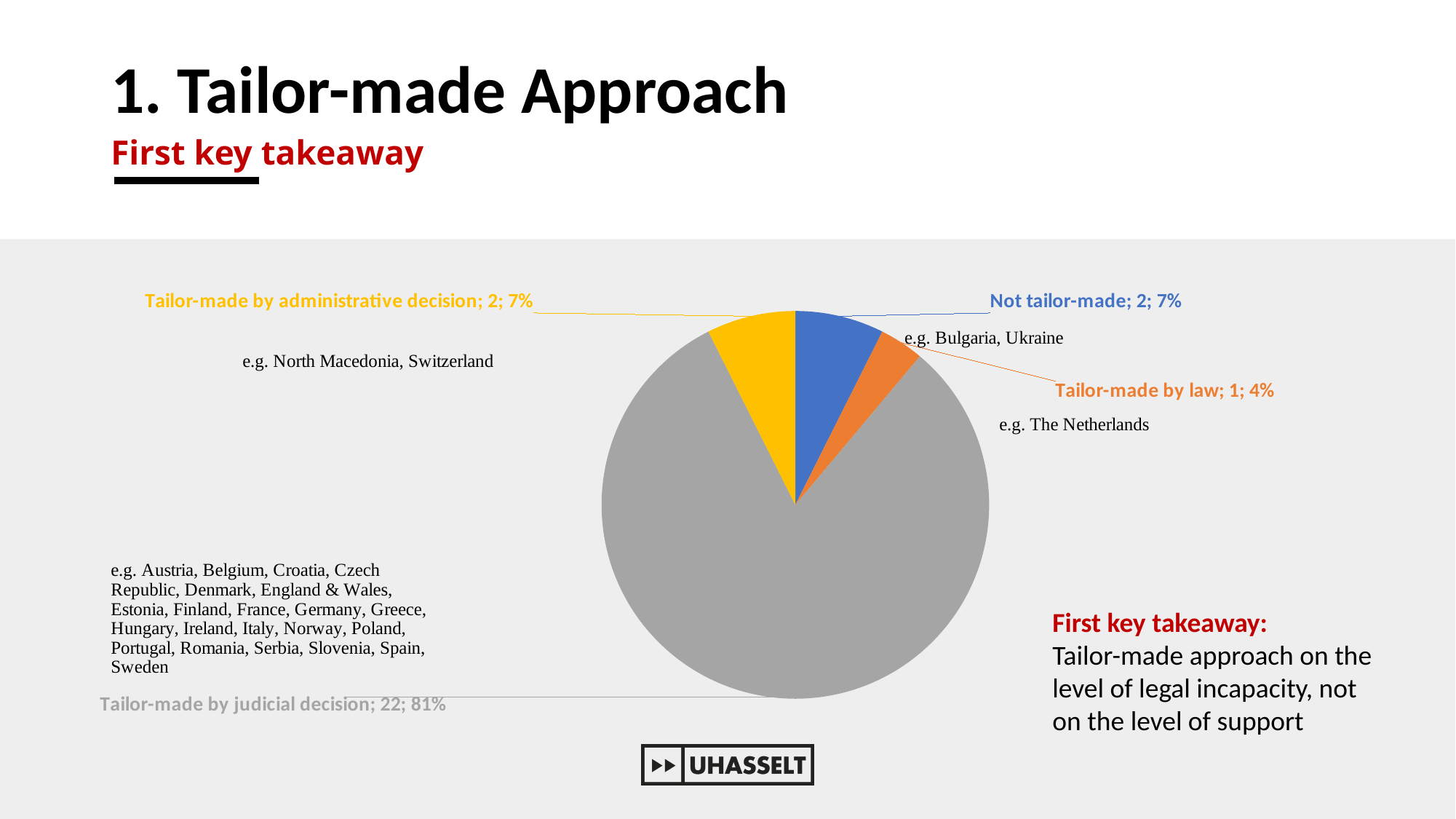
What is the count for 'Tailor-made by judicial decision'? 22 Which category has the largest slice? Tailor-made by judicial decision What is the count for 'Tailor-made by law'? 1 Which category has the smallest slice? Tailor-made by law What is the count for 'Not tailor-made'? 2 Which is larger, the count for 'Not tailor-made' or the count for 'Tailor-made by law'? Not tailor-made What colour is the 'Tailor-made by administrative decision' slice? yellow What kind of chart is shown on the slide? pie chart How many slices does the pie chart have? 4 What percentage share does 'Tailor-made by administrative decision' have? 7% What is the difference in count between 'Tailor-made by judicial decision' and 'Tailor-made by administrative decision'? 20 What percentage share does 'Tailor-made by judicial decision' have? 81%